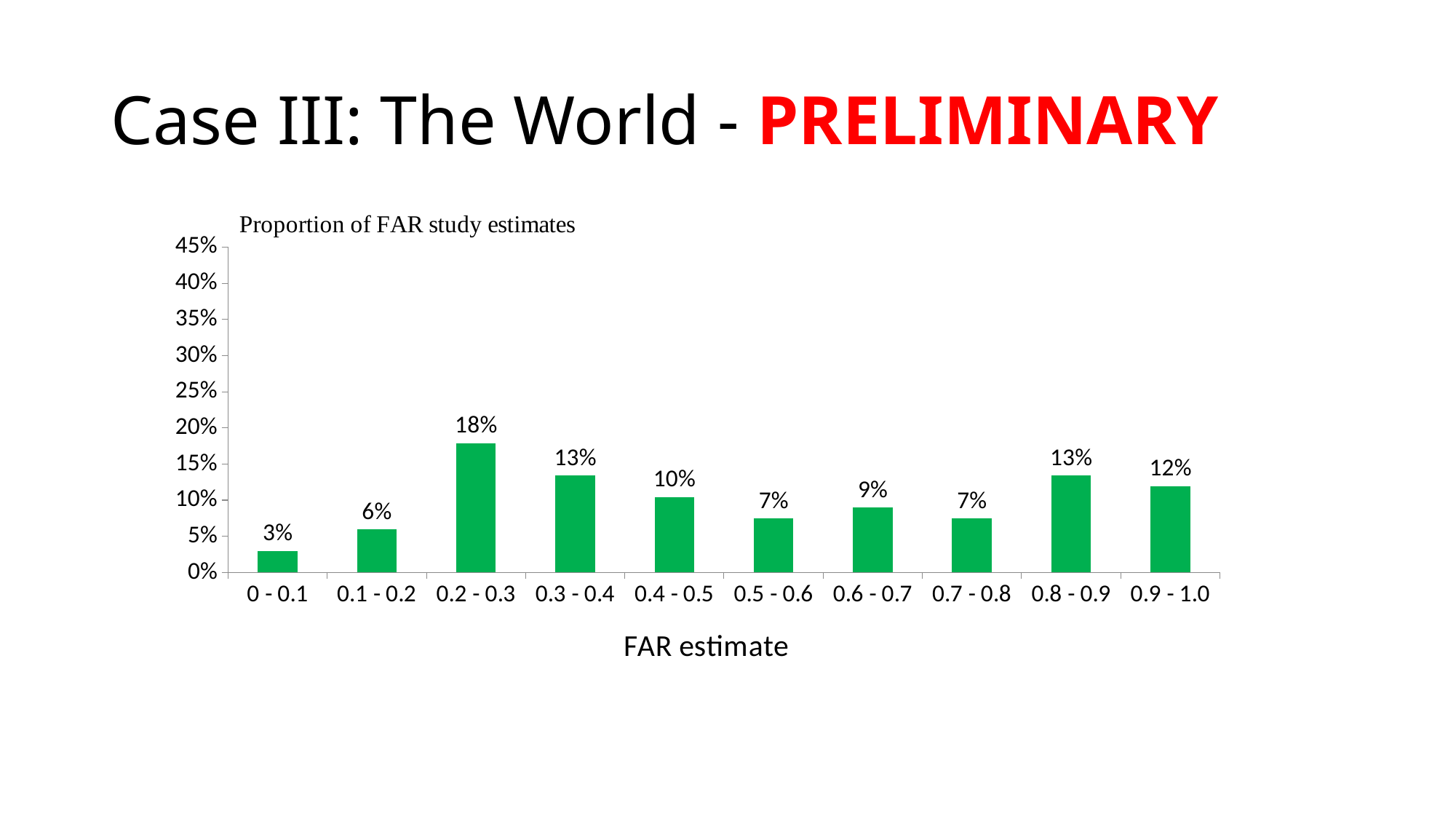
What is the label of the x axis? FAR estimate Is the value for the 0.3 - 0.4 bin greater or less than 10%? greater Which FAR estimate bin has the highest proportion of study estimates? 0.2 - 0.3 What is the difference between the proportions for the 0.2 - 0.3 bin and the 0.1 - 0.2 bin? 12% How many FAR estimate bins are shown on the x axis? 10 What is the proportion of FAR study estimates for the 0.4 - 0.5 bin? 10% What is the title of the chart? Proportion of FAR study estimates Which FAR estimate bin has the lowest proportion of study estimates? 0 - 0.1 What is the proportion of FAR study estimates for the 0.2 - 0.3 bin? 18% Which bin has a larger proportion, 0.6 - 0.7 or 0.8 - 0.9? 0.8 - 0.9 What kind of chart is shown on the slide? Bar chart What is the proportion of FAR study estimates for the 0.9 - 1.0 bin? 12%